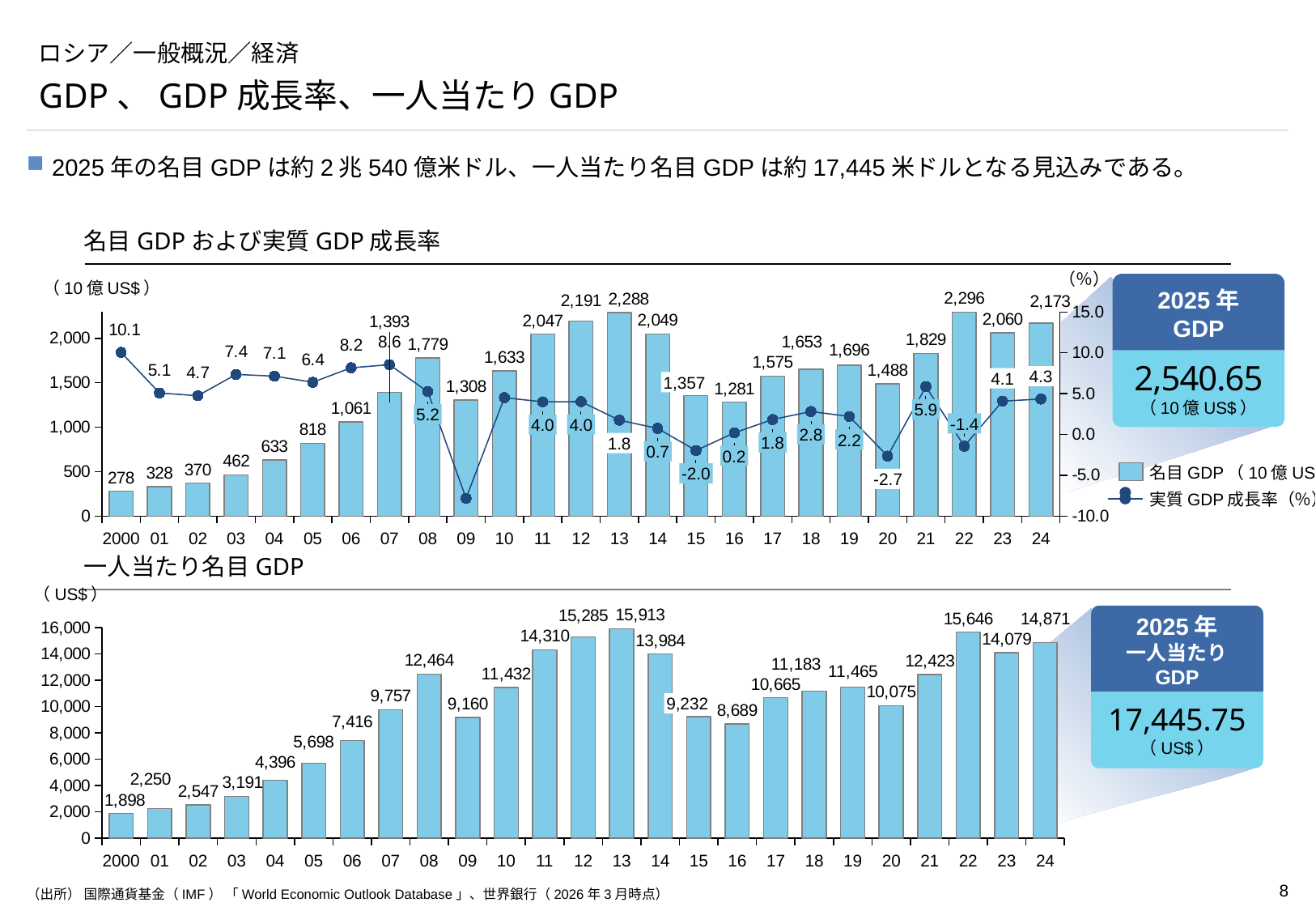
In the top chart, which year has the lowest nominal GDP bar? 2000 In the bottom chart (一人当たり名目 GDP), what is the value for 2016? 8,689 In the top chart, which year has the highest nominal GDP bar? 22 In the bottom chart, what is the difference between the values for 2013 and 2012? 628 How many series does the legend of the top chart list? 2 In the top chart, what is the difference between the nominal GDP of 2024 and 2023? 113 In the top chart (名目 GDP および実質 GDP 成長率), what is the nominal GDP value for 2024? 2,173 In the top chart, what is the real GDP growth rate for 2021? 5.9 In the bottom chart, which year has the highest per-capita nominal GDP? 13 In the top chart, which year has the larger nominal GDP, 2008 or 2010? 2008 What kind of chart is the bottom chart (一人当たり名目 GDP)? bar chart In the top chart, is the real GDP growth rate for 2009 greater or less than -5.0? less